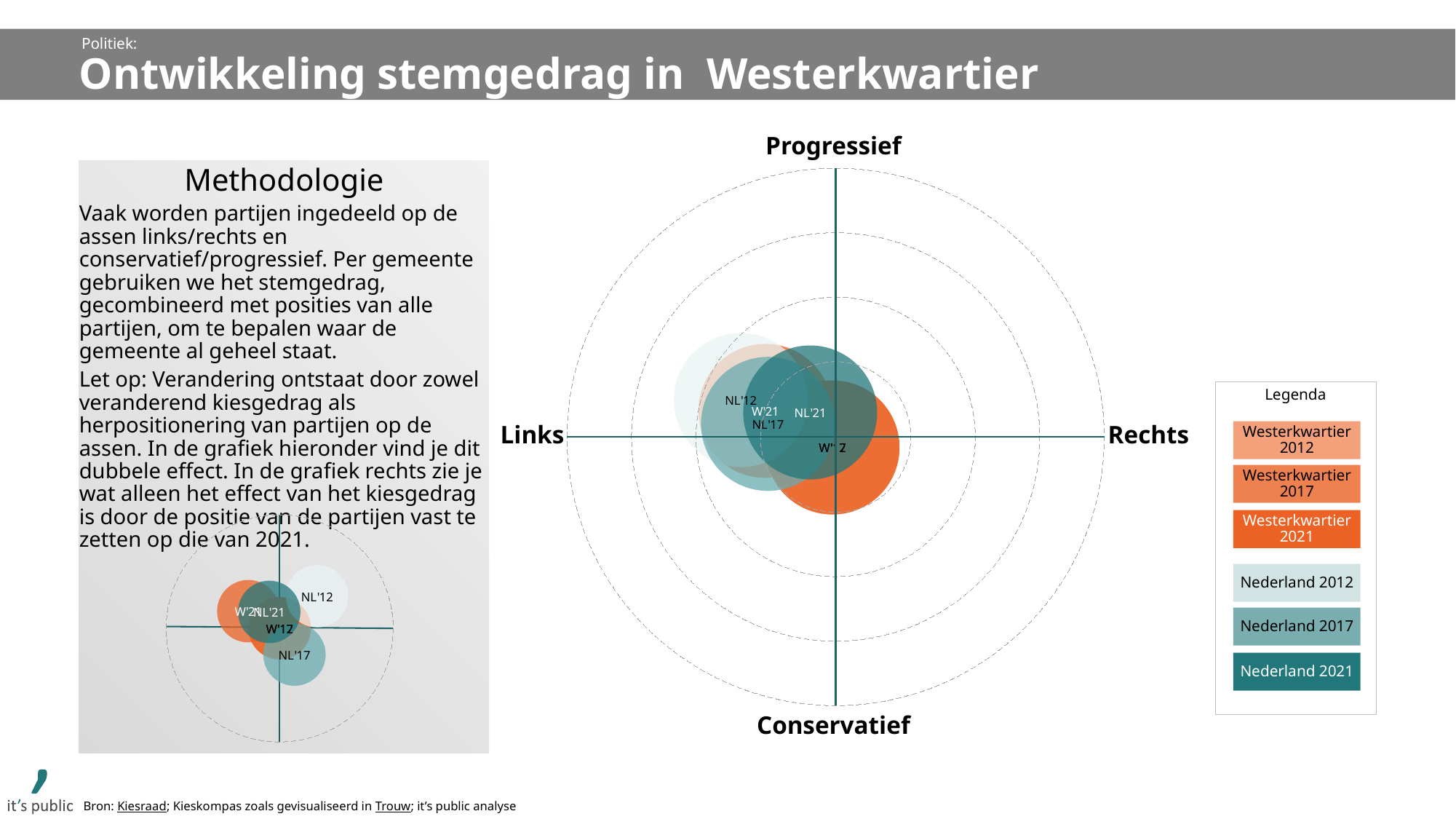
In the small chart at the bottom left, is the NL'12 bubble to the left or to the right of the vertical axis? right In the small chart at the bottom left, is the W'21 bubble to the left or to the right of the vertical axis? left What kind of chart is the large chart in the centre of the slide? bubble chart In the main chart, is the Nederland 2012 bubble (NL'12) to the left or to the right of the vertical axis? left How many entries does the legend (Legenda) list? 6 Which label appears at the left end of the horizontal axis of the main chart? Links Which label appears at the top of the vertical axis of the main chart? Progressief